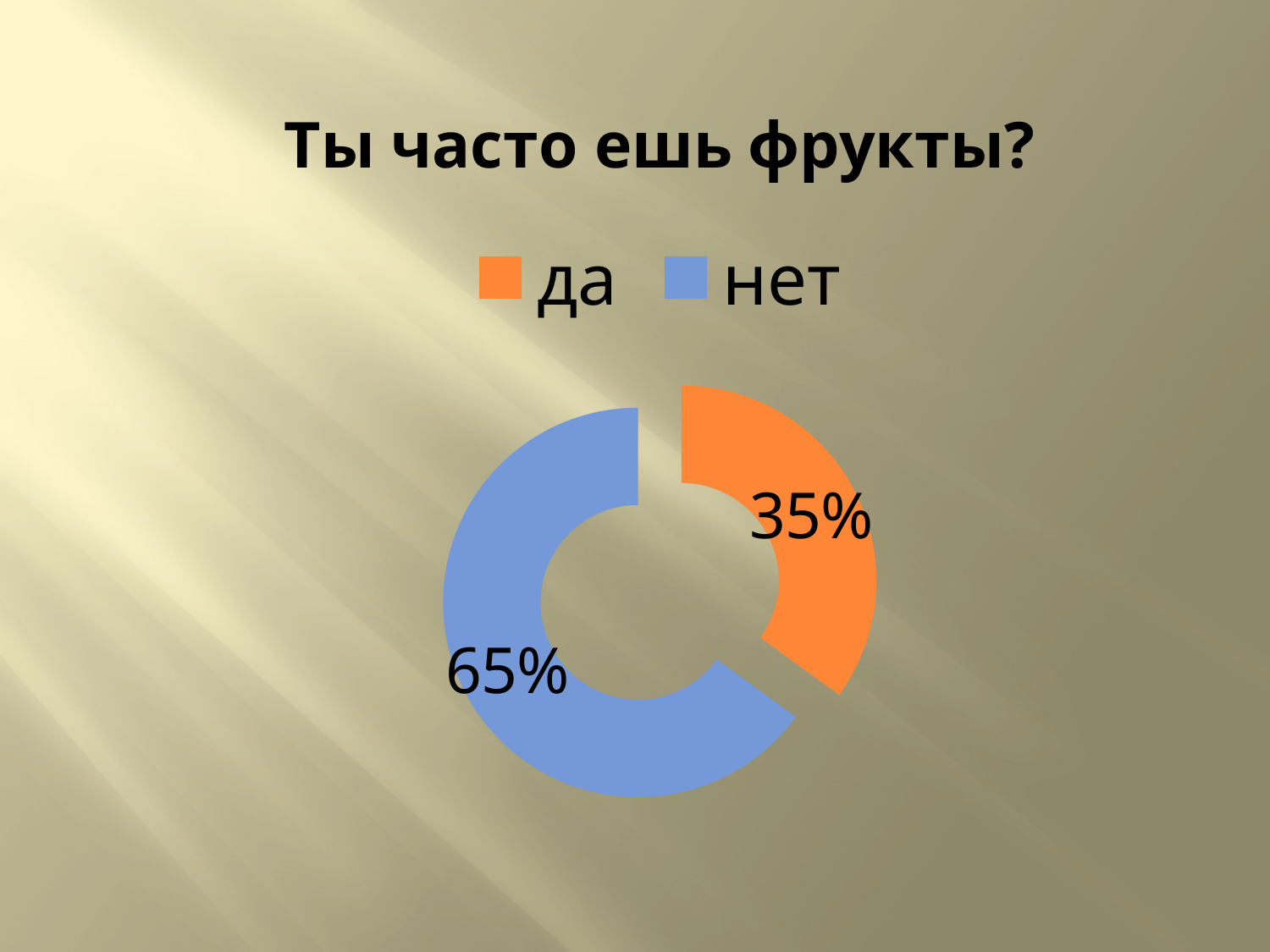
What is the total of the two shares shown in the chart? 100% Which answer has the larger share, "да" or "нет"? нет How many categories are shown in the chart? 2 What percentage of respondents answered "нет"? 65% How many entries does the legend list? 2 Which category has the smallest share of the chart? да What colour represents the "нет" category? Blue What percentage of respondents answered "да"? 35% What is the difference in percentage points between "нет" and "да"? 30% Which category has the largest share of the chart? нет What kind of chart is shown on the slide? Doughnut (pie) chart What is the title of the chart? Ты часто ешь фрукты?